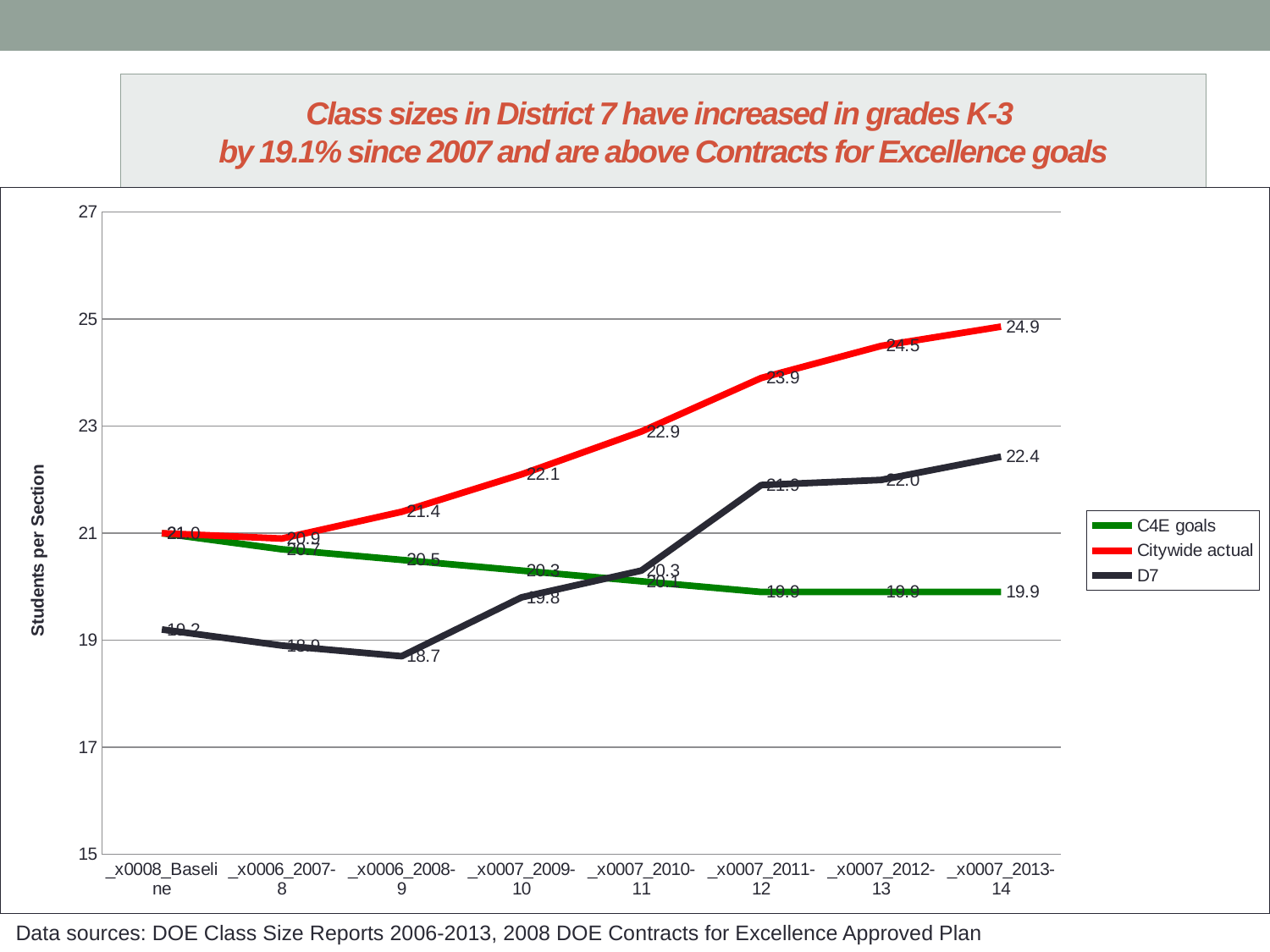
How many series does the legend list? 3 What kind of chart is shown on the slide? line chart In which year does the D7 series reach its lowest value? 2008-9 What is the difference between the Citywide actual and D7 values in 2013-14? 2.5 What is the Citywide actual value for 2009-10? 22.1 What is the title of the vertical axis? Students per Section What is the C4E goals value for 2013-14? 19.9 What is the Citywide actual value for 2013-14? 24.9 What is the D7 value for 2008-9? 18.7 Does the Citywide actual series rise or fall from 2008-9 to 2013-14? rise Which series has the highest value in 2013-14? Citywide actual What is the D7 value for 2013-14? 22.4